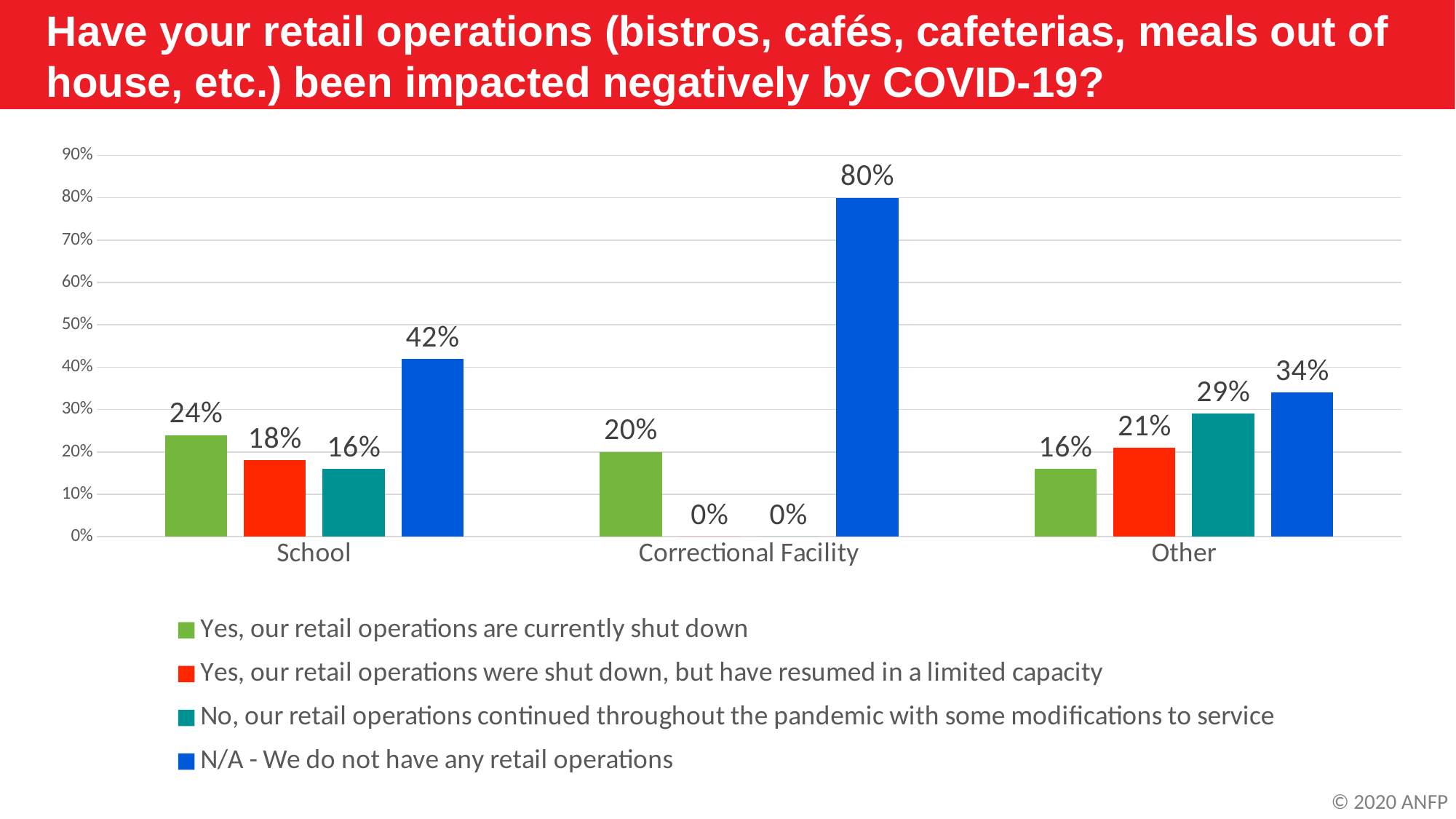
Which category has the lowest value for "Yes, our retail operations are currently shut down"? Other What percentage of School respondents answered "N/A - We do not have any retail operations"? 42% What is the difference between the "N/A - We do not have any retail operations" values for Correctional Facility and School? 38% Which is larger: the "Yes, our retail operations were shut down, but have resumed in a limited capacity" value for School or for Other? Other Which category has the highest value for "N/A - We do not have any retail operations"? Correctional Facility Which colour represents "N/A - We do not have any retail operations" in the legend? Blue How many series does the legend list? 4 What percentage of Other respondents said their retail operations continued throughout the pandemic with some modifications to service? 29% What percentage of Correctional Facility respondents said their retail operations are currently shut down? 20% How many categories are shown on the x axis? 3 What percentage of Correctional Facility respondents said their retail operations continued throughout the pandemic with some modifications to service? 0% What kind of chart is shown on the slide? Bar chart